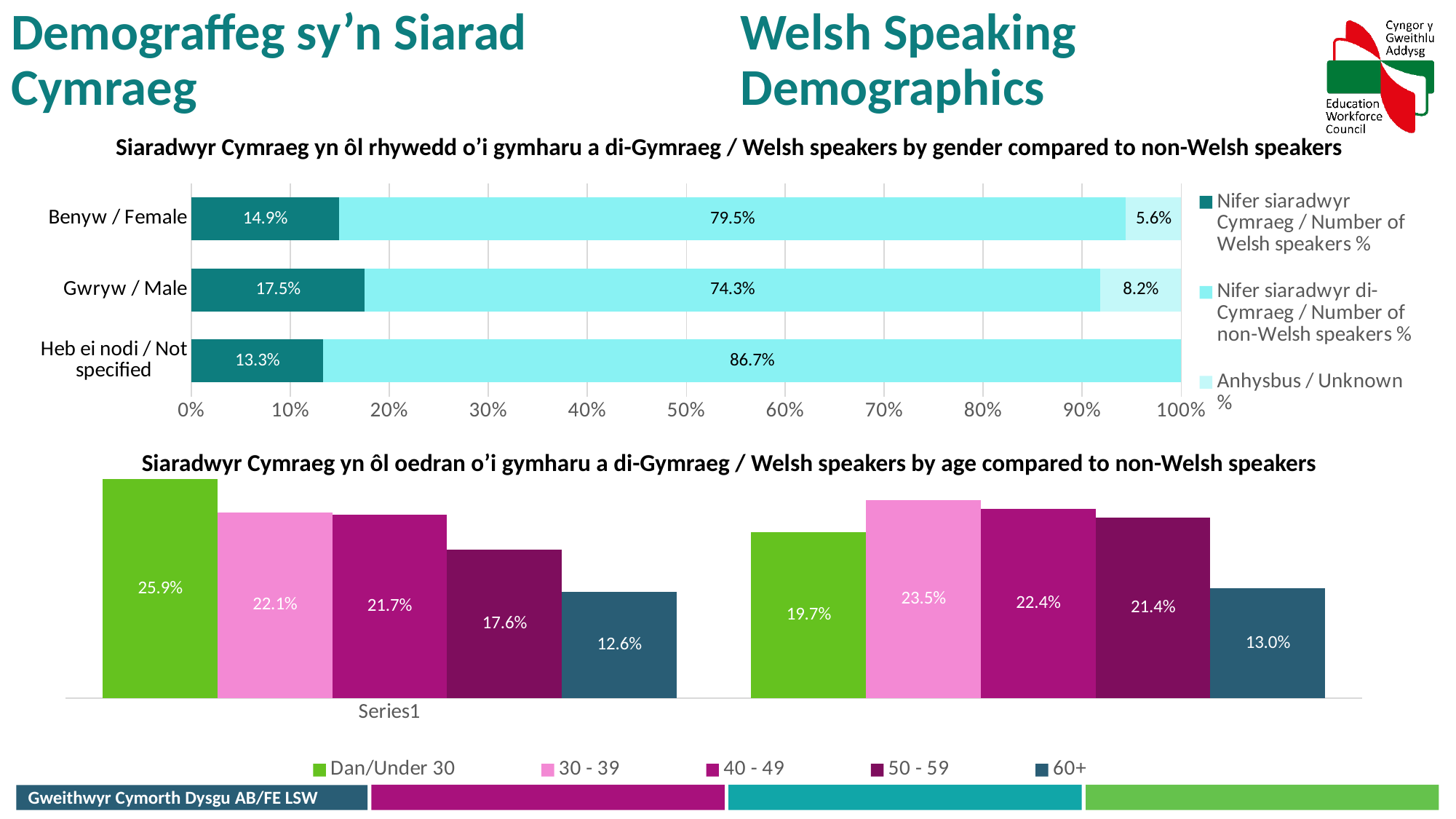
In the chart 'Welsh speakers by gender compared to non-Welsh speakers', what is the difference between the Number of Welsh speakers % for Gwryw / Male and Benyw / Female? 2.6% In the chart 'Welsh speakers by age compared to non-Welsh speakers', how many age bands does the legend list? 5 In the chart 'Welsh speakers by gender compared to non-Welsh speakers', how many series does the legend list? 3 In the chart 'Welsh speakers by age compared to non-Welsh speakers', which age band has the highest value in the right group of bars? 30 - 39 In the chart 'Welsh speakers by gender compared to non-Welsh speakers', what is the Number of non-Welsh speakers % for Gwryw / Male? 74.3% In the chart 'Welsh speakers by gender compared to non-Welsh speakers', what is the Unknown % for Gwryw / Male? 8.2% In the chart 'Welsh speakers by age compared to non-Welsh speakers', which age band has the lowest value in the left group of bars? 60+ In the chart 'Welsh speakers by age compared to non-Welsh speakers', what is the value for Dan/Under 30 in the left group of bars? 25.9% In the chart 'Welsh speakers by gender compared to non-Welsh speakers', how many categories are shown on the vertical axis? 3 In the chart 'Welsh speakers by gender compared to non-Welsh speakers', which category has the highest Number of Welsh speakers %? Gwryw / Male What kind of chart is 'Welsh speakers by gender compared to non-Welsh speakers'? Stacked bar chart In the chart 'Welsh speakers by gender compared to non-Welsh speakers', what is the Number of Welsh speakers % for Benyw / Female? 14.9%